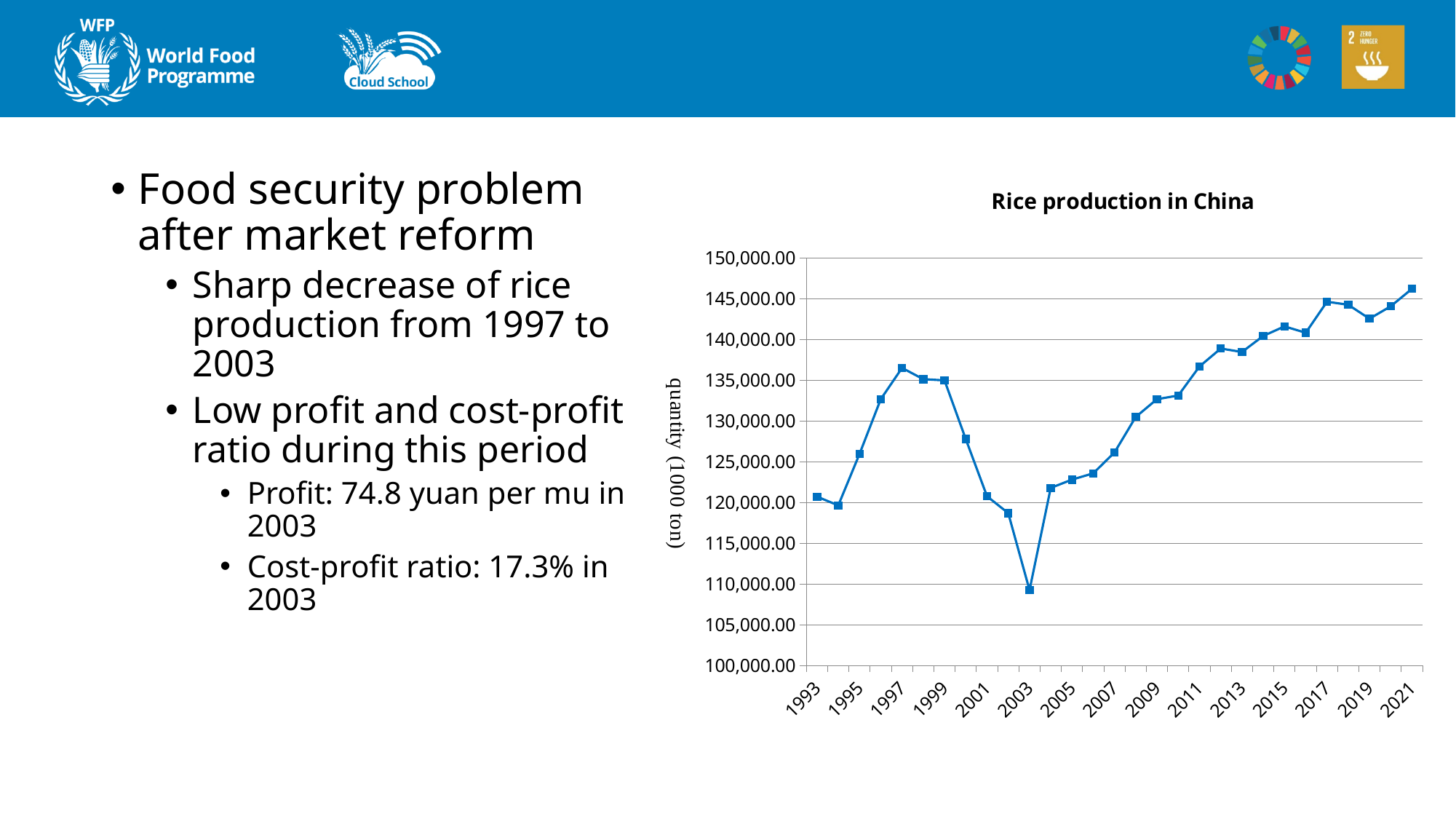
What is the title of the chart? Rice production in China What kind of chart is shown on the slide? Line chart What is the label of the vertical axis of the chart? quantity (1000 ton) Which year has the larger rice production, 1997 or 2021? 2021 Is the value for 2021 greater or less than 145,000.00? greater In which year is rice production lowest in the chart? 2003 Does rice production rise or fall between 1997 and 2003? Fall Is the value for 2005 greater or less than 125,000.00? less Does rice production rise or fall between 2003 and 2021? Rise Is the value for 1997 greater or less than 135,000.00? greater In which year is rice production highest in the chart? 2021